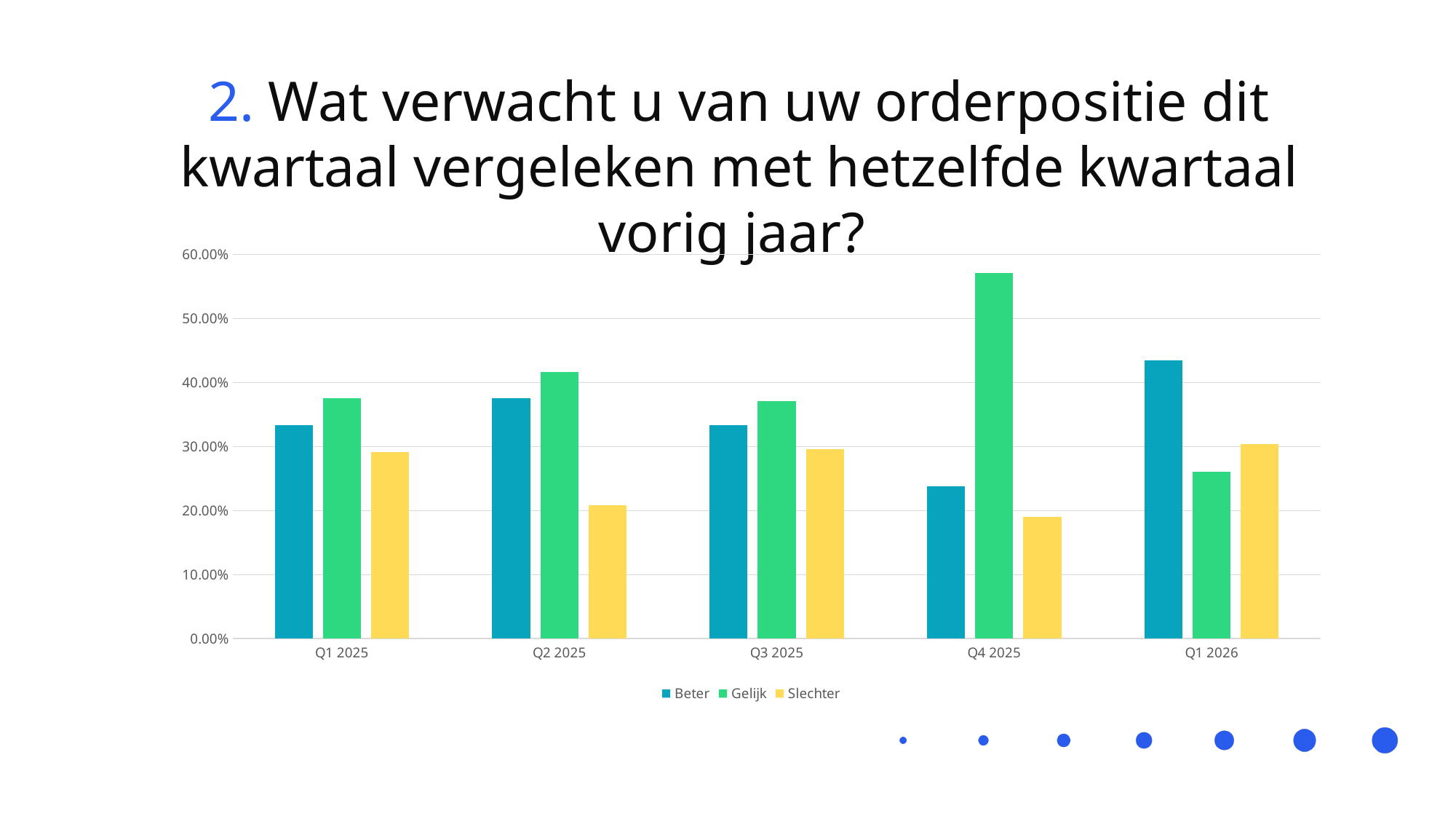
Is the value for Slechter in Q2 2025 greater or less than 30.00%? less How many series does the legend list? 3 Is the value for Gelijk in Q4 2025 greater or less than 50.00%? greater Is the value for Beter in Q1 2026 greater or less than 40.00%? greater In which quarter is the value for Slechter the lowest? Q4 2025 In Q1 2026, which is larger: Beter or Gelijk? Beter How many quarters are shown on the x axis? 5 What kind of chart is shown on the slide? bar chart In which quarter is the value for Beter the highest? Q1 2026 In which quarter is the value for Gelijk the highest? Q4 2025 What are the three entries in the legend? Beter, Gelijk, Slechter Does the value for Beter rise or fall from Q4 2025 to Q1 2026? rise